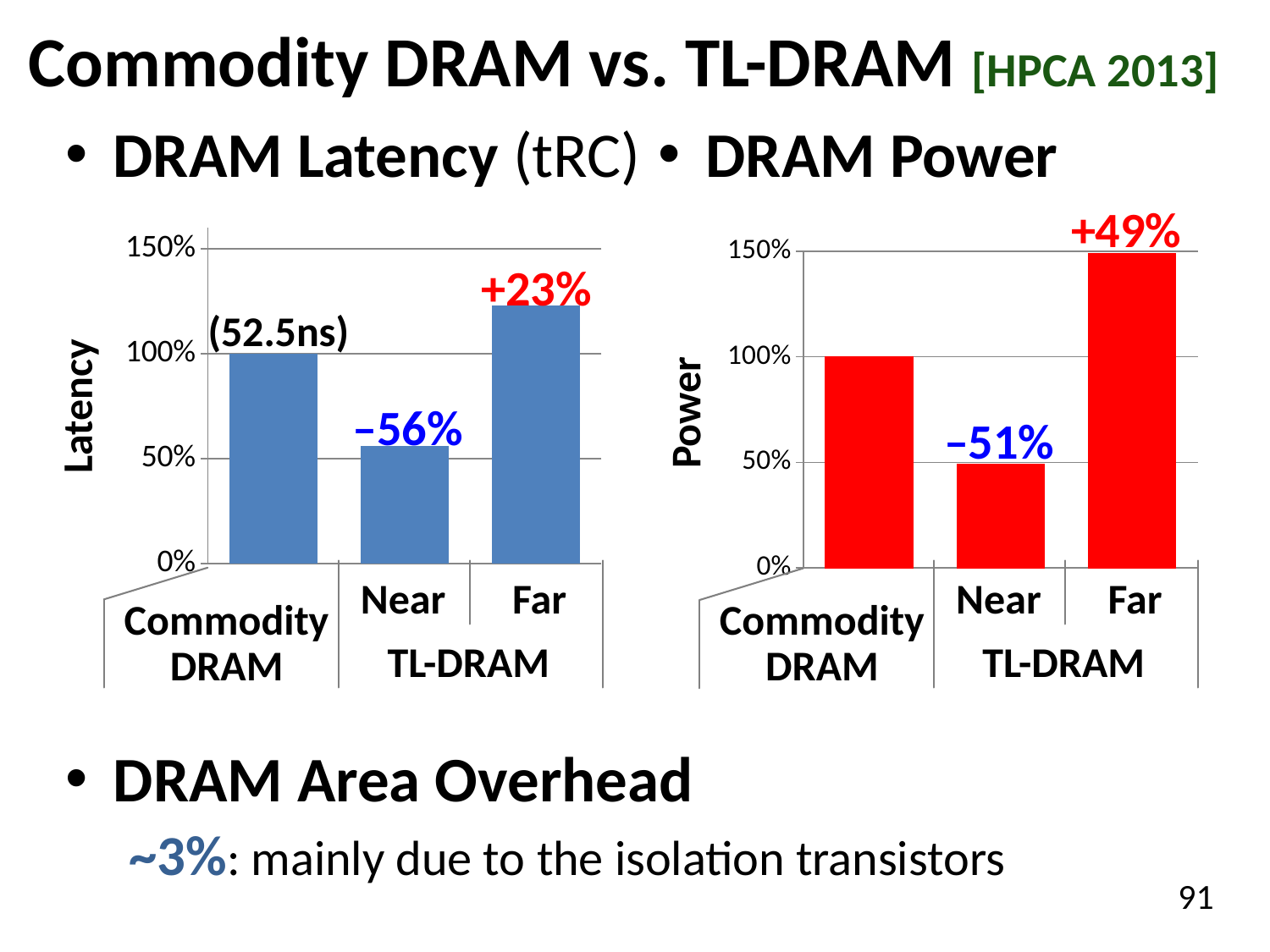
In the DRAM Power chart, what percentage change is labelled on the TL-DRAM Far bar? +49% In the DRAM Latency chart, what value does the Commodity DRAM bar reach on the axis? 100% In the DRAM Latency chart, what percentage change is labelled on the TL-DRAM Far bar? +23% In the DRAM Latency chart, which bar is the lowest? Near (TL-DRAM) What type of chart is the DRAM Latency chart? bar chart In the DRAM Latency chart, how many bars are plotted? 3 In the DRAM Power chart, what percentage change is labelled on the TL-DRAM Near bar? –51% In the DRAM Latency chart, what absolute latency is annotated on the Commodity DRAM bar? 52.5ns In the DRAM Latency chart, is the value for the TL-DRAM Near bar greater or less than 50%? greater In the DRAM Power chart, which bar is the highest? Far (TL-DRAM) In the DRAM Power chart, is the value for the TL-DRAM Far bar greater or less than 100%? greater In the DRAM Latency chart, what percentage change is labelled on the TL-DRAM Near bar? –56%